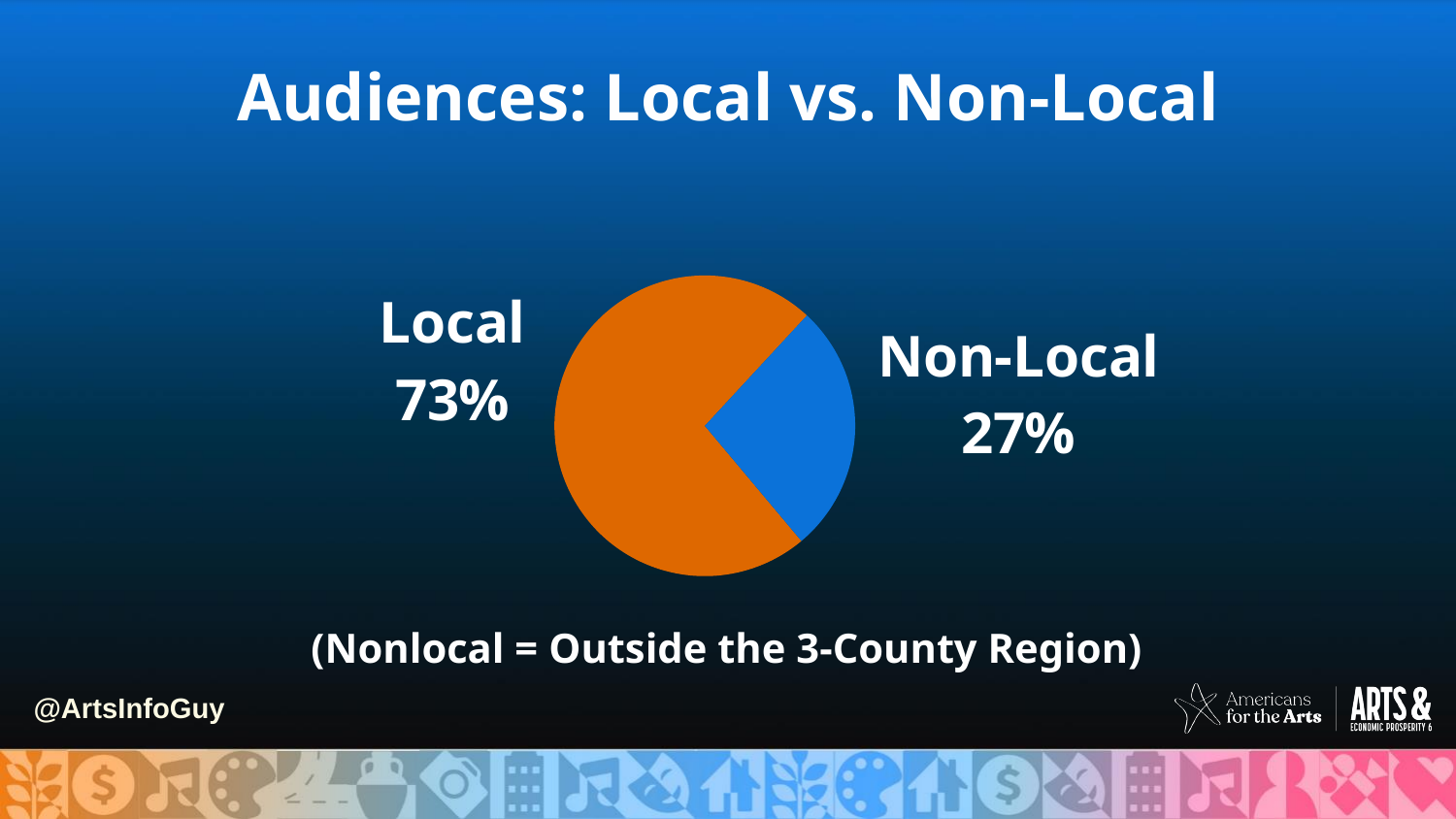
What share of audiences is Non-Local? 27% Which is larger, the Local share or the Non-Local share? Local Which slice of the pie is the smallest? Non-Local Which slice of the pie is the largest? Local How many slices does the pie chart have? 2 What share of audiences is Local? 73% What is the difference in percentage points between the Local and Non-Local shares? 46 What is the total of the two slices shown in the pie chart? 100% What kind of chart is shown on the slide? Pie chart What is the title of the slide? Audiences: Local vs. Non-Local What colour is the Non-Local slice of the pie? Blue